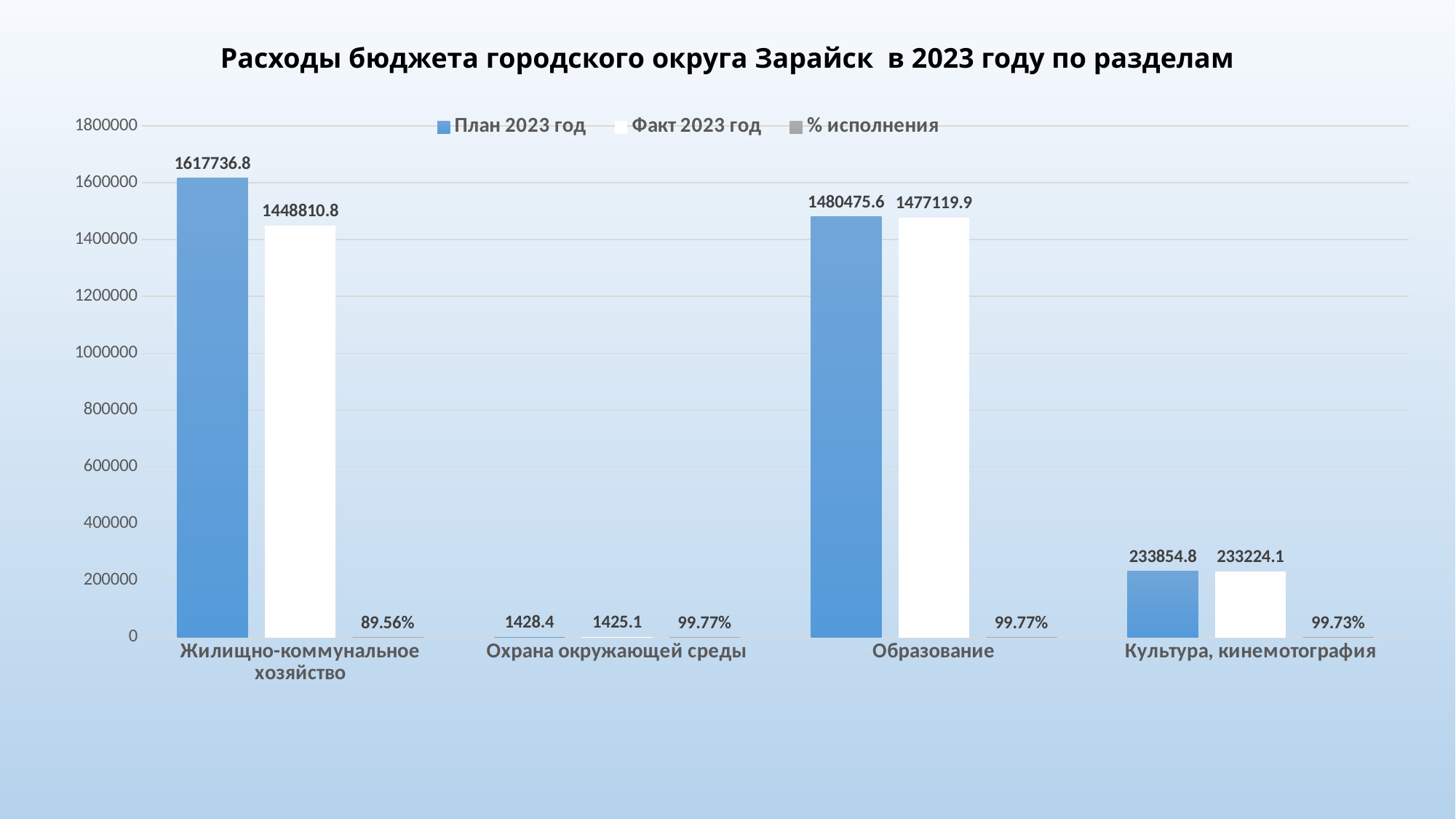
What is the % исполнения for Культура, кинемотография? 99.73% What is the value of План 2023 год for Охрана окружающей среды? 1428.4 Which category has the highest План 2023 год value? Жилищно-коммунальное хозяйство Which category has the lowest % исполнения? Жилищно-коммунальное хозяйство Which is larger for Образование: План 2023 год or Факт 2023 год? План 2023 год What is the value of План 2023 год for Жилищно-коммунальное хозяйство? 1617736.8 How many series does the legend list? 3 What is the value of Факт 2023 год for Образование? 1477119.9 What is the difference between План 2023 год and Факт 2023 год for Жилищно-коммунальное хозяйство? 168926.0 Which category has the lowest Факт 2023 год value? Охрана окружающей среды What type of chart is shown on the slide? bar chart How many categories are shown on the x axis? 4